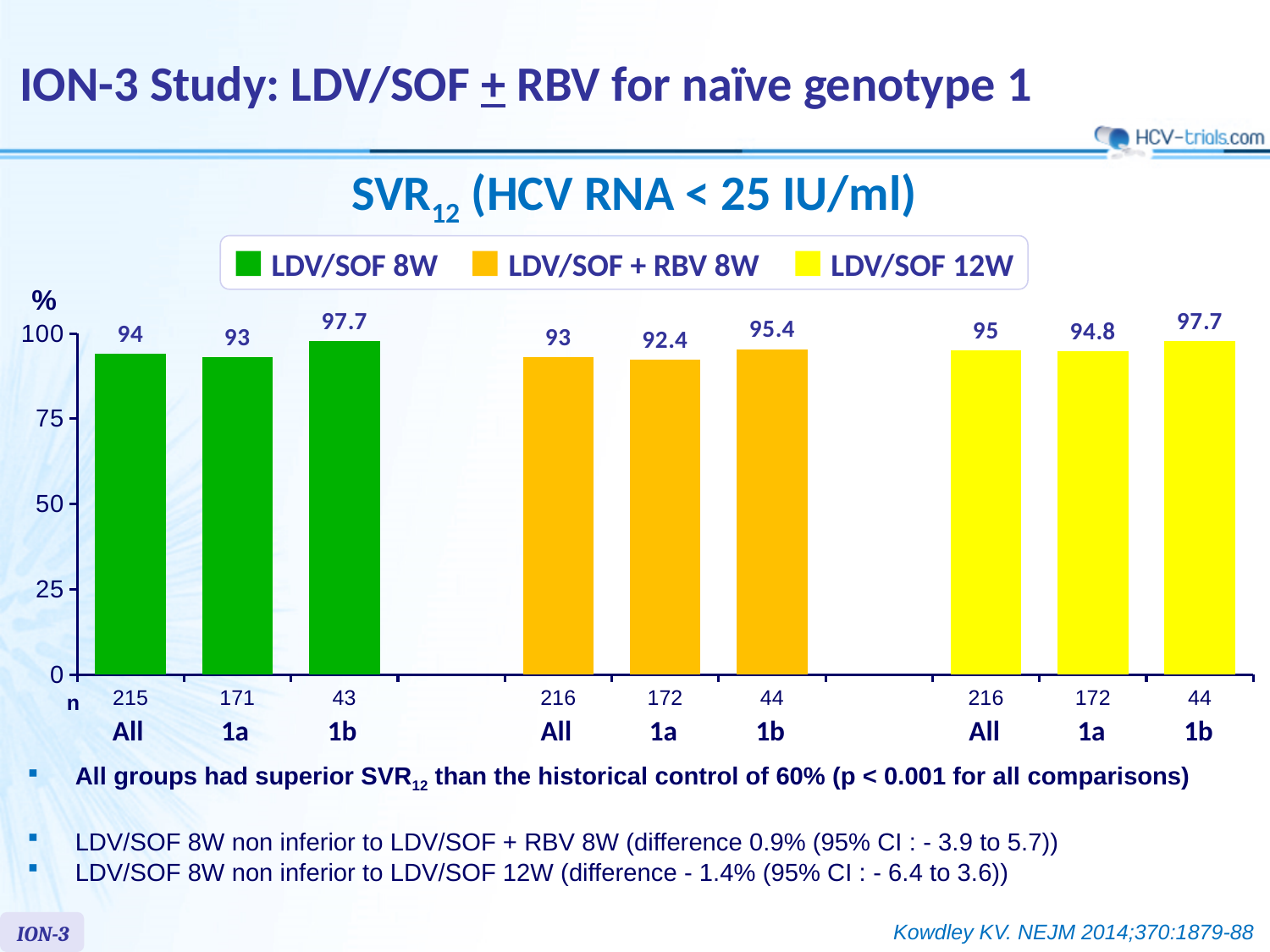
Within the LDV/SOF + RBV 8W arm, which subgroup has the highest SVR12 rate? 1b How many bars are plotted in the chart? 9 Is the SVR12 rate for the 1a subgroup in the LDV/SOF 8W arm greater or less than 75? greater How many series does the legend list? 3 What is the SVR12 rate for the All group in the LDV/SOF 12W arm? 95 Which subgroup has the lowest SVR12 rate across all arms? 1a in LDV/SOF + RBV 8W How many patients (n) are in the 1b subgroup of the LDV/SOF 8W arm? 43 What type of chart is shown on the slide? Bar chart What is the SVR12 rate for the 1a subgroup in the LDV/SOF + RBV 8W arm? 92.4 Which is larger: the SVR12 rate for All in the LDV/SOF 8W arm or for All in the LDV/SOF + RBV 8W arm? LDV/SOF 8W What is the difference in SVR12 rate between the 1b and 1a subgroups in the LDV/SOF 12W arm? 2.9 What is the SVR12 rate for the 1b subgroup in the LDV/SOF 8W arm? 97.7